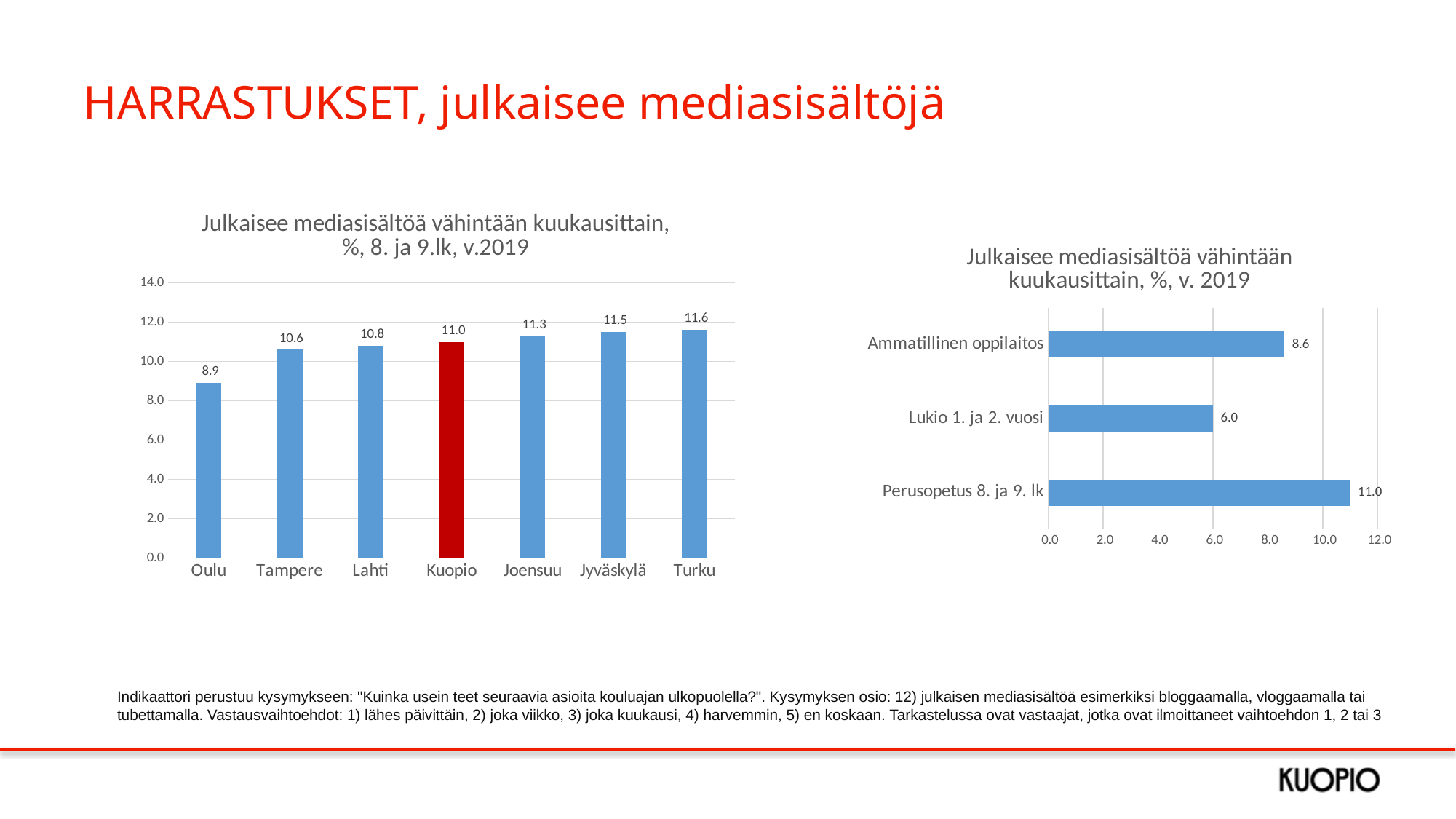
In the left chart, which city has the highest value? Turku In the left chart, what is the difference between the values for Turku and Oulu? 2.7 In the left chart (Julkaisee mediasisältöä vähintään kuukausittain, %, 8. ja 9.lk, v.2019), what is the value for Kuopio? 11.0 In the right chart, what is the difference between the values for Ammatillinen oppilaitos and Lukio 1. ja 2. vuosi? 2.6 In the left chart, which bar is coloured red instead of blue? Kuopio In the left chart, do the values rise or fall from Oulu to Turku along the x axis? rise In the right chart (Julkaisee mediasisältöä vähintään kuukausittain, %, v. 2019), what is the value for Lukio 1. ja 2. vuosi? 6.0 In the left chart, which is larger, the value for Tampere or the value for Joensuu? Joensuu In the left chart, which city has the lowest value? Oulu In the left chart, what is the value for Oulu? 8.9 How many cities are shown in the left chart? 7 In the right chart, which category has the highest value? Perusopetus 8. ja 9. lk